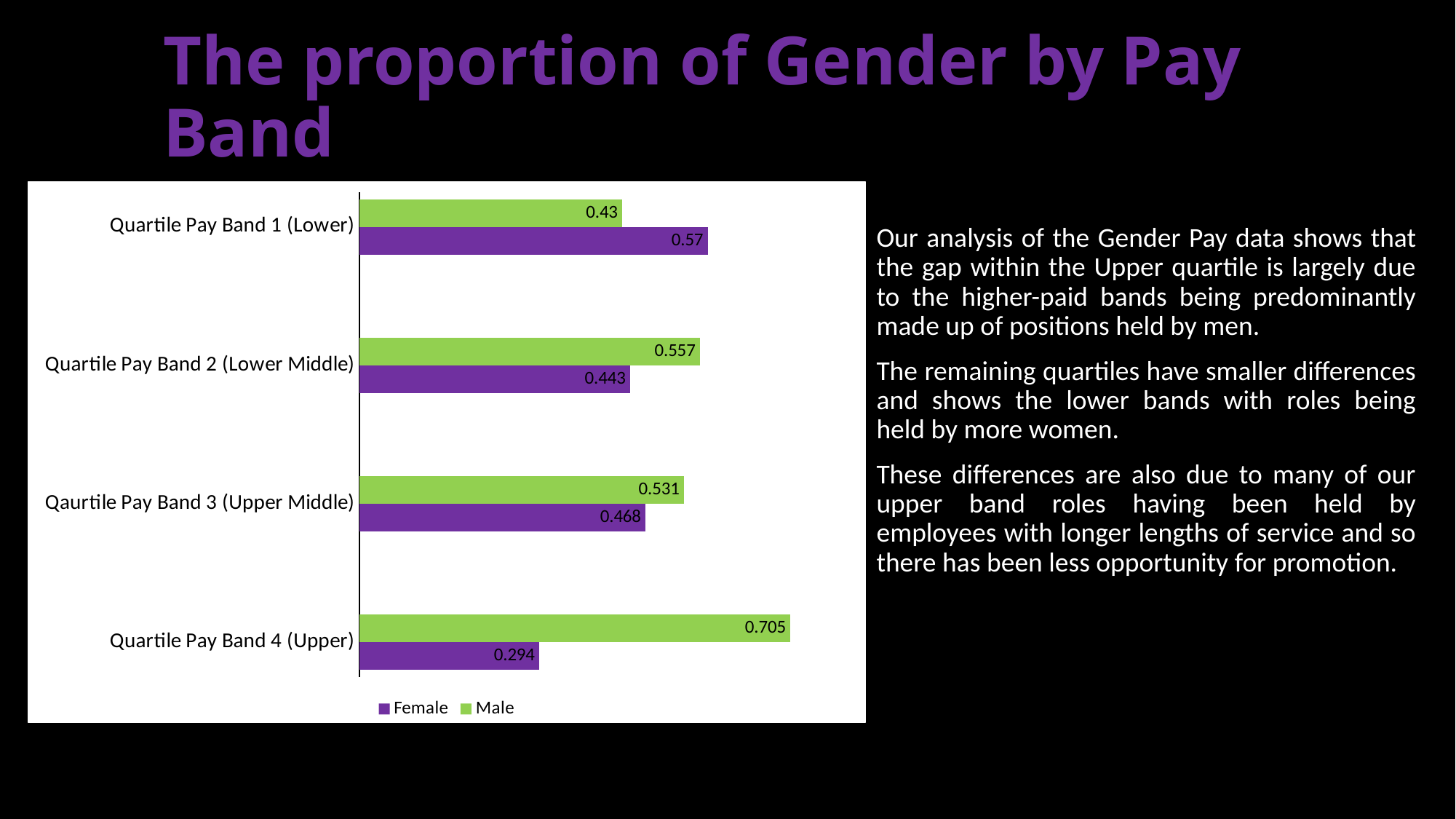
Which is larger for Quartile Pay Band 2 (Lower Middle), the Male value or the Female value? Male Which colour represents the Female series in the chart? Purple What is the Female value for Quartile Pay Band 2 (Lower Middle)? 0.443 How many pay band categories are shown in the chart? 4 Which pay band has the lowest Female value? Quartile Pay Band 4 (Upper) What is the Male value for Qaurtile Pay Band 3 (Upper Middle)? 0.531 What is the difference between the Male and Female values for Quartile Pay Band 4 (Upper)? 0.411 Which pay band has the highest Male value? Quartile Pay Band 4 (Upper) What kind of chart is shown on the slide? Bar chart What is the Female value for Quartile Pay Band 1 (Lower)? 0.57 How many series does the legend list? 2 What is the Male value for Quartile Pay Band 4 (Upper)? 0.705